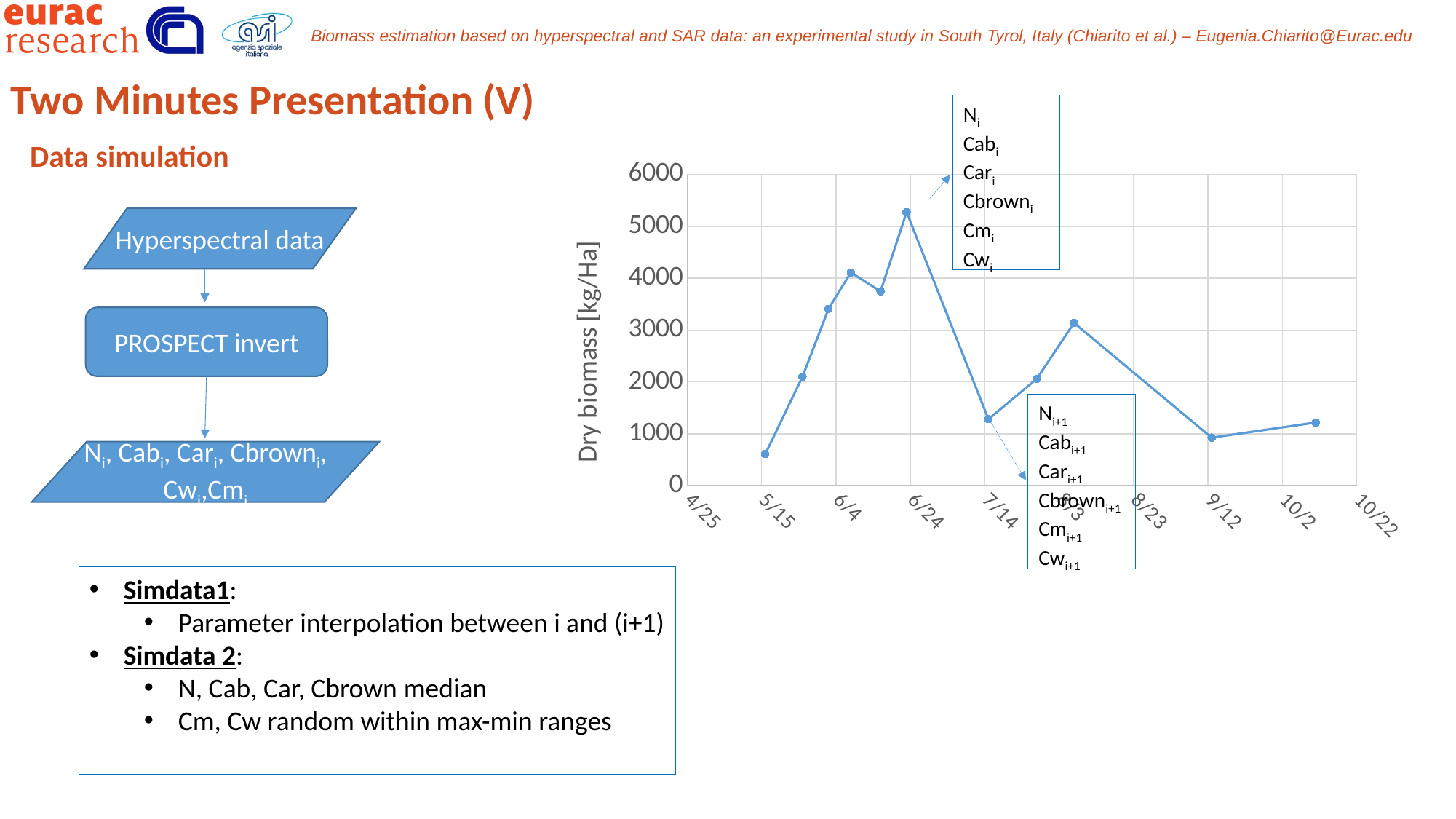
Around which x-axis date does the dry biomass reach its highest value? 6/24 How many data points are plotted on the line in the chart? 11 What is the highest value shown on the vertical axis of the chart? 6000 Is the first plotted dry biomass value near 5/15 greater or less than 1000? less Is the dry biomass value at 7/14 greater or less than 2000? less Does the dry biomass rise or fall between 6/24 and 7/14? fall What kind of chart is shown on the slide? line chart Around which x-axis date does the dry biomass have its lowest value? 5/15 What is the label of the vertical axis of the chart? Dry biomass [kg/Ha] Which is larger: the dry biomass peak near 6/24 or the peak near 8/3? the peak near 6/24 Is the peak dry biomass value near 6/24 greater or less than 5000? greater Does the dry biomass rise or fall between 5/15 and 6/24? rise